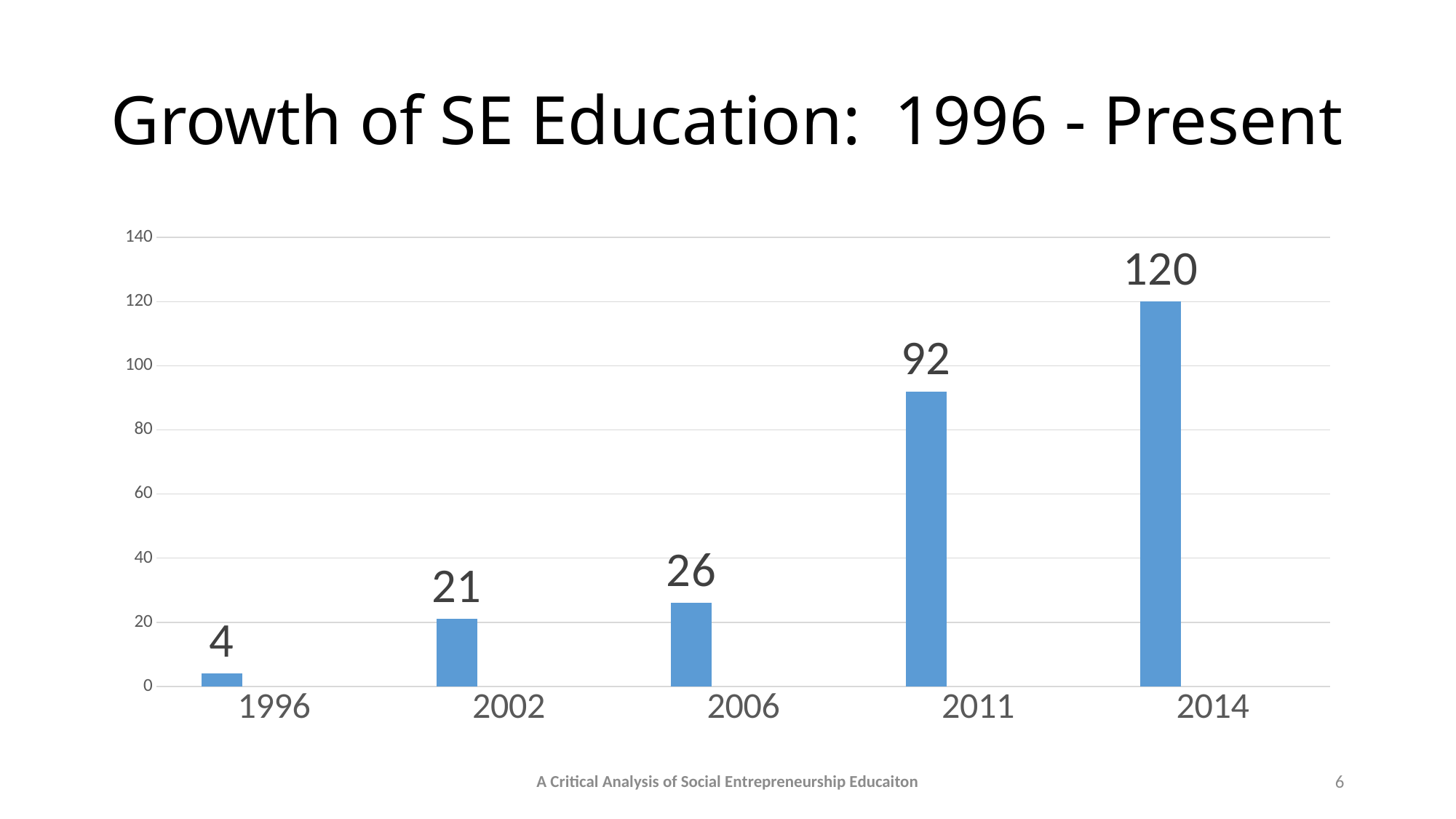
What is the value for 2011? 92 Which is larger, the value for 2002 or the value for 2006? 2006 What is the difference between the values for 2006 and 2002? 5 What is the value for 1996? 4 What is the difference between the values for 2014 and 2011? 28 What is the value for 2006? 26 Is the value for 2011 greater or less than 100? less Which year has the highest value? 2014 How many years are shown on the x axis? 5 Do the values rise or fall from 1996 to 2014? rise Which year has the lowest value? 1996 What kind of chart is shown on the slide? bar chart